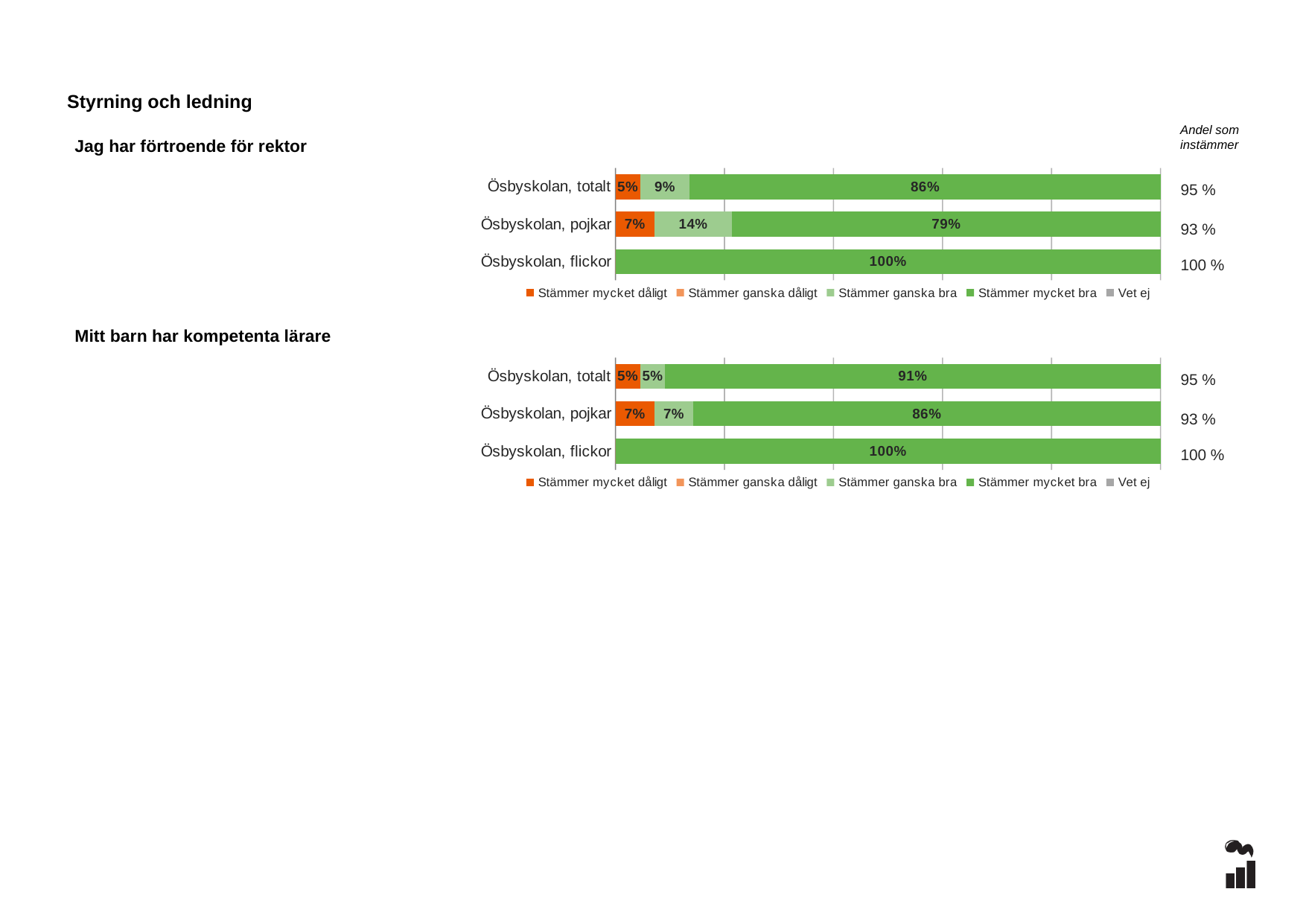
How many series does the legend of the chart "Mitt barn har kompetenta lärare" list? 5 In the chart "Jag har förtroende för rektor", what is the "Stämmer ganska bra" value for Ösbyskolan, totalt? 9% In the chart "Jag har förtroende för rektor", what is the "Stämmer mycket bra" value for Ösbyskolan, pojkar? 79% In the chart "Jag har förtroende för rektor", what is the difference between the "Stämmer ganska bra" values for Ösbyskolan, pojkar and Ösbyskolan, totalt? 5% In the chart "Mitt barn har kompetenta lärare", what is the "Stämmer mycket dåligt" value for Ösbyskolan, pojkar? 7% In the chart "Jag har förtroende för rektor", what is the "Andel som instämmer" value shown for Ösbyskolan, pojkar? 93 % What kind of chart is "Jag har förtroende för rektor"? Stacked bar chart In the chart "Mitt barn har kompetenta lärare", what is the "Stämmer mycket bra" value for Ösbyskolan, totalt? 91% How many categories are shown in the chart "Jag har förtroende för rektor"? 3 In the chart "Mitt barn har kompetenta lärare", which category has the lowest "Stämmer mycket bra" value? Ösbyskolan, pojkar In the chart "Jag har förtroende för rektor", which category has the highest "Stämmer mycket bra" value? Ösbyskolan, flickor In the chart "Mitt barn har kompetenta lärare", which is larger: the "Stämmer mycket bra" value for Ösbyskolan, totalt or for Ösbyskolan, pojkar? Ösbyskolan, totalt